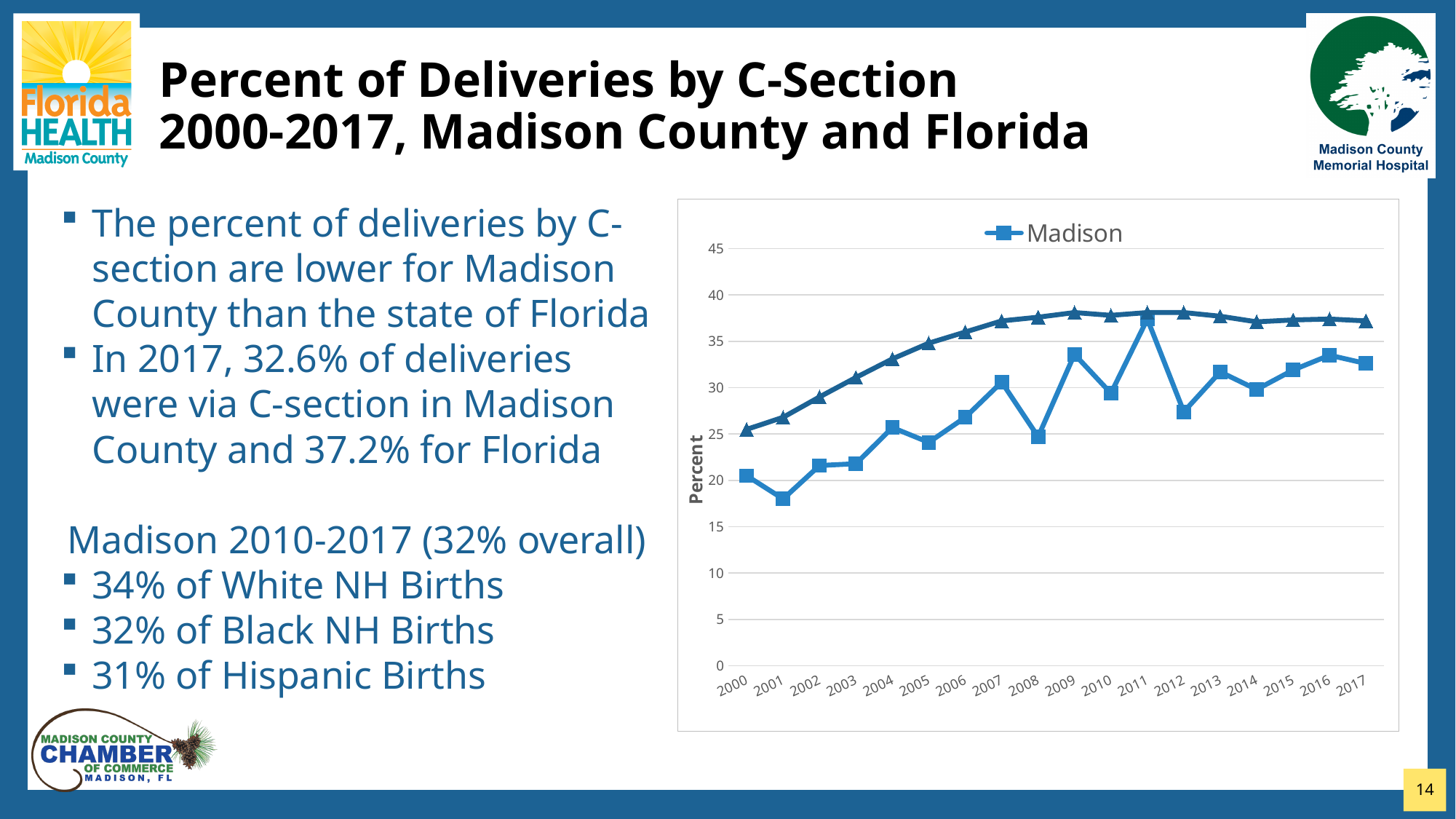
What series name appears in the chart's legend? Madison How many series does the chart's legend list? 1 Is the Madison value for 2011 greater or less than 35? greater In which year is the Madison series at its highest value? 2011 Is the Madison value for 2009 greater or less than 30? greater In which year is the Madison series at its lowest value? 2001 Is the Madison value for 2001 greater or less than 20? less Does the Madison series overall rise or fall from 2000 to 2017? rise What is the label on the chart's vertical axis? Percent How many years are plotted along the x axis of the chart? 18 What kind of chart is shown on the slide? line chart In 2005, which line is higher: the Madison square-marker line or the triangle-marker line? the triangle-marker line